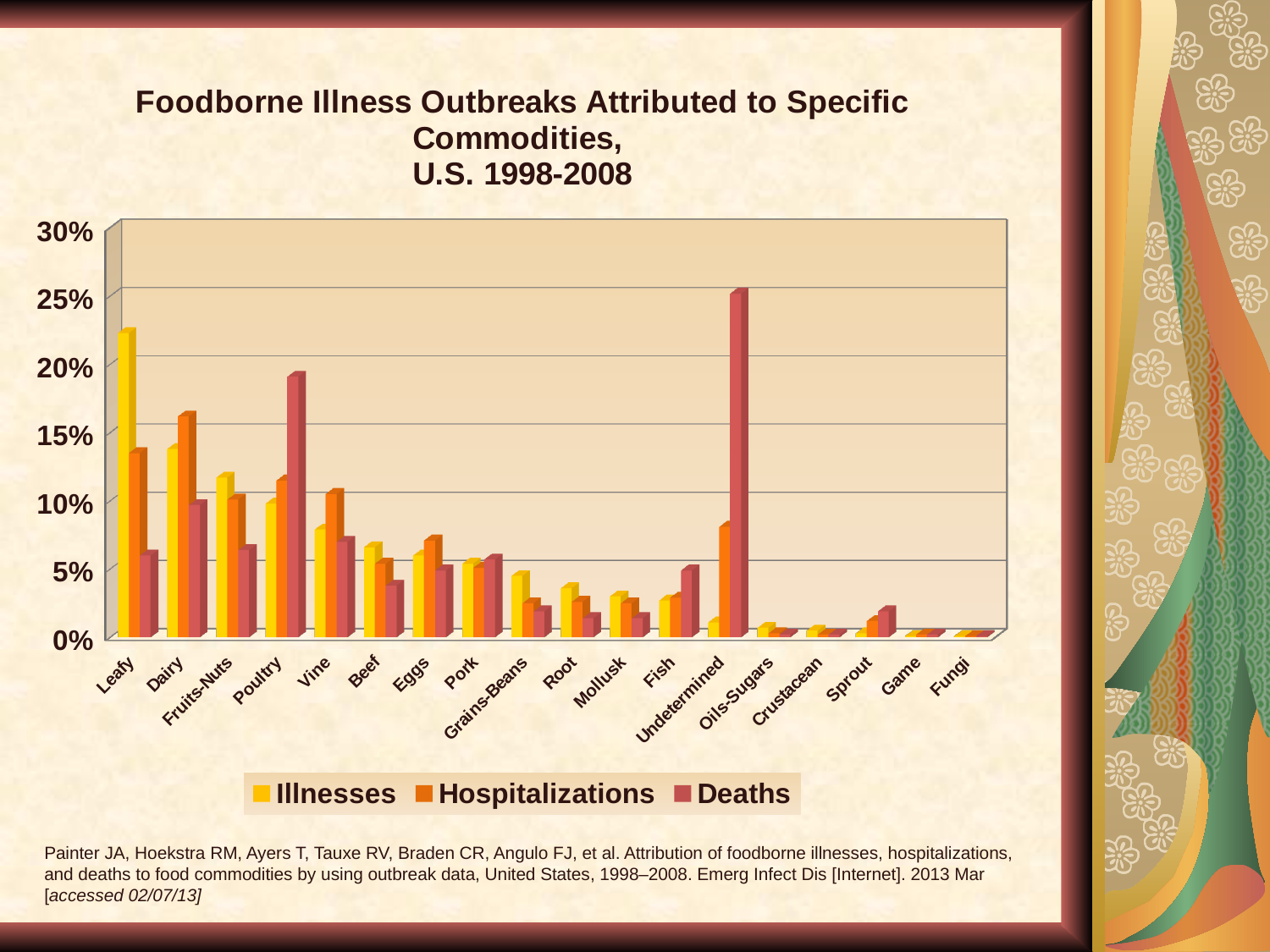
Is the Hospitalizations value for Beef greater or less than 10%? less Which category has the highest Deaths value? Undetermined How many commodity categories are shown on the x axis? 18 Is the Illnesses value for Leafy greater or less than 20%? greater Is the Deaths value for Undetermined greater or less than 20%? greater What kind of chart is shown on the slide? Bar chart What are the three series named in the legend? Illnesses, Hospitalizations, Deaths How many series does the legend list? 3 Which commodity has the highest Hospitalizations value? Dairy Which is larger for Poultry, the Illnesses value or the Deaths value? Deaths Which commodity has the highest Illnesses value? Leafy